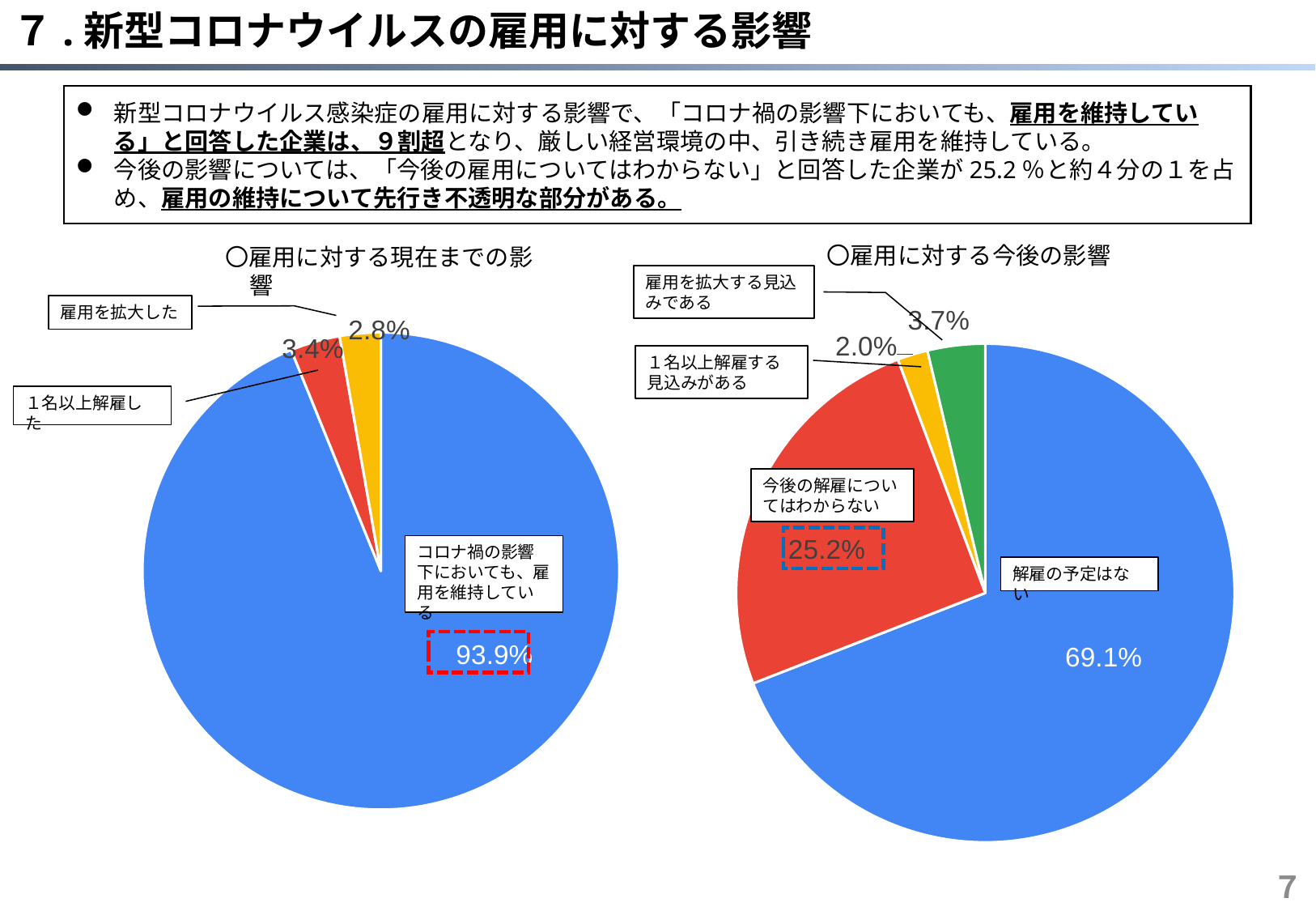
In the right pie chart (雇用に対する今後の影響), what is the difference in percentage points between 「解雇の予定はない」 and 「今後の解雇についてはわからない」? 43.9 In the left pie chart (雇用に対する現在までの影響), which is larger: 「１名以上解雇した」 or 「雇用を拡大した」? １名以上解雇した In the right pie chart (雇用に対する今後の影響), what percentage of companies answered 「雇用を拡大する見込みである」? 3.7% What type of chart is used for 雇用に対する現在までの影響 on the left? Pie chart In the left pie chart (雇用に対する現在までの影響), what percentage of companies answered 「１名以上解雇した」? 3.4% In the right pie chart (雇用に対する今後の影響), which category has the smallest share? １名以上解雇する見込みがある In the right pie chart (雇用に対する今後の影響), what percentage of companies answered 「解雇の予定はない」? 69.1% How many slices does the right pie chart (雇用に対する今後の影響) have? 4 In the left pie chart (雇用に対する現在までの影響), what percentage of companies answered 「コロナ禍の影響下においても、雇用を維持している」? 93.9% In the left pie chart (雇用に対する現在までの影響), which category has the largest share? コロナ禍の影響下においても、雇用を維持している In the left pie chart (雇用に対する現在までの影響), what percentage of companies answered 「雇用を拡大した」? 2.8% In the right pie chart (雇用に対する今後の影響), what percentage of companies answered 「今後の解雇についてはわからない」? 25.2%